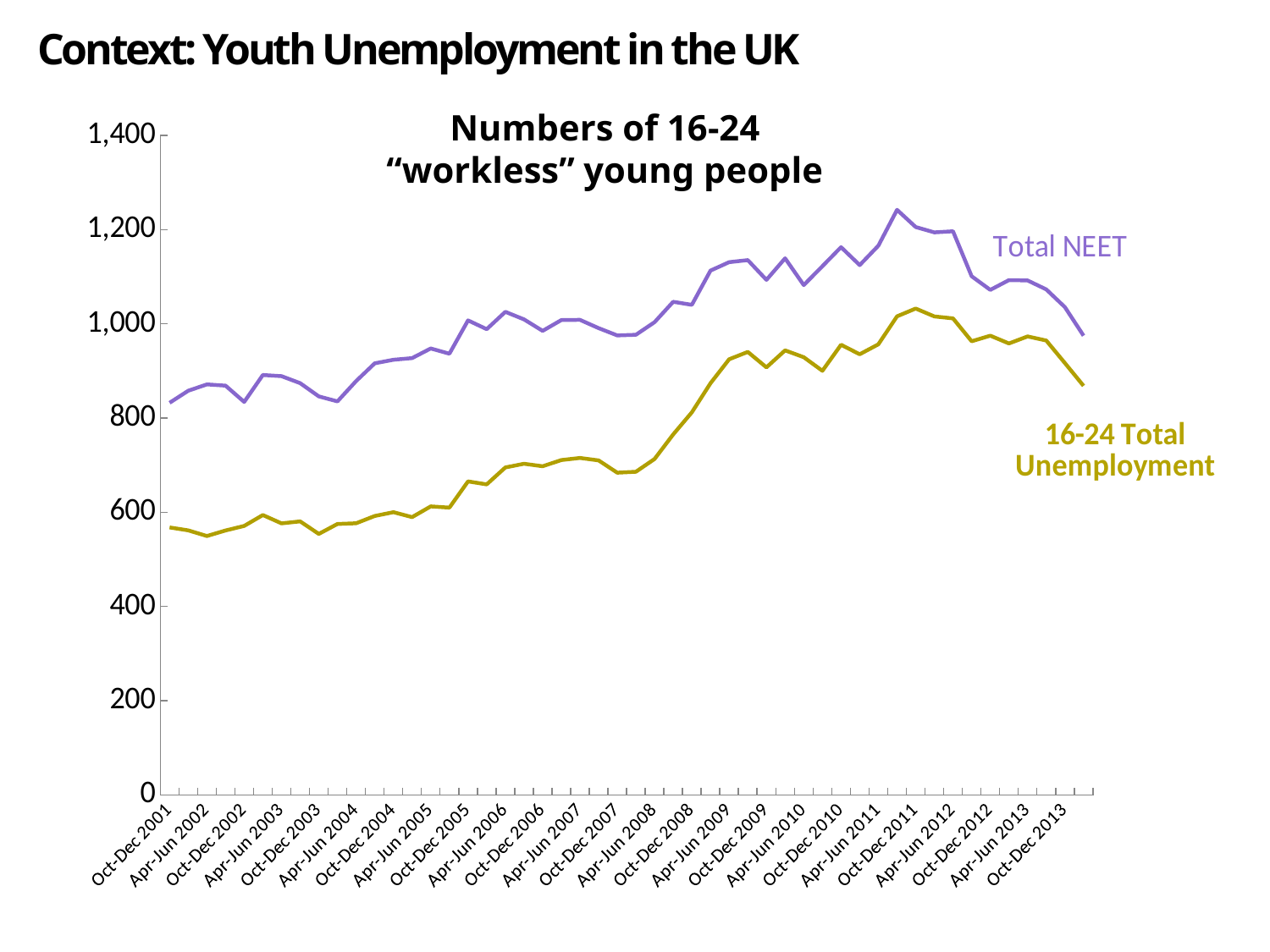
Does 16-24 Total Unemployment rise or fall overall between Oct-Dec 2001 and Oct-Dec 2011? Rise What kind of chart is shown on the slide? Line chart What is the title of the chart? Numbers of 16-24 "workless" young people Is the value for Total NEET at Oct-Dec 2001 greater or less than 800? greater Does Total NEET rise or fall overall between Oct-Dec 2011 and Oct-Dec 2013? Fall How many series are plotted on the chart? 2 Which series has the higher value at Oct-Dec 2001, Total NEET or 16-24 Total Unemployment? Total NEET Which series is drawn in purple? Total NEET Is the value for 16-24 Total Unemployment at Oct-Dec 2001 greater or less than 600? less Is the value for 16-24 Total Unemployment at Oct-Dec 2011 greater or less than 1,000? greater